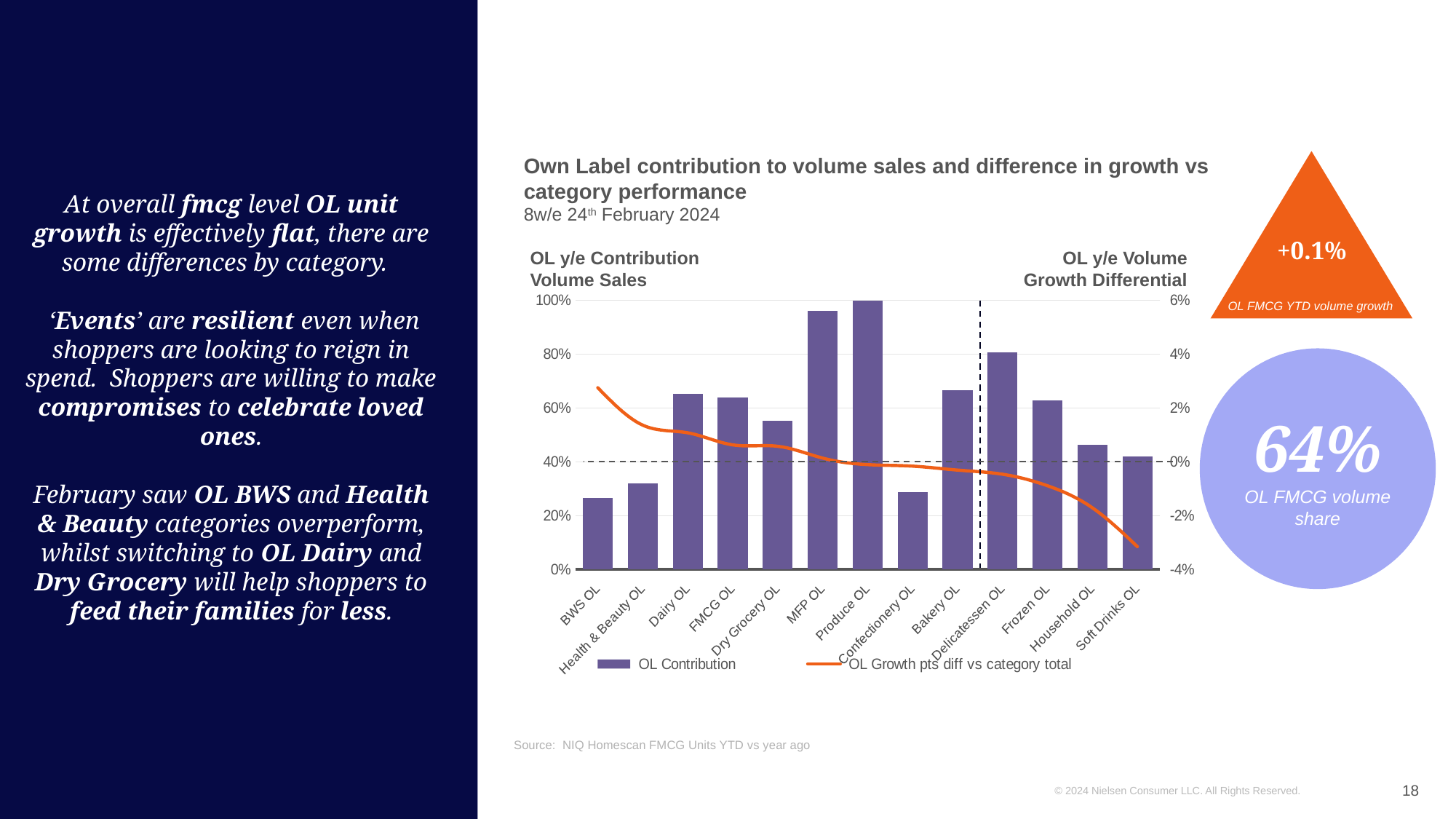
Does the OL Growth pts diff vs category total line generally rise or fall from left to right across the categories? fall How many series does the chart legend list? 2 Is the OL Contribution value for MFP OL greater or less than 80%? greater What period does the chart subtitle state the data covers? 8w/e 24th February 2024 Is the OL Contribution value for BWS OL greater or less than 40%? less What kind of chart is shown on the slide? A bar chart combined with a line Is the OL Contribution value for Household OL greater or less than 60%? less Which has the larger OL Contribution bar, Dairy OL or Health & Beauty OL? Dairy OL Which category has the highest OL Contribution bar? Produce OL How many categories are shown on the x axis of the chart? 13